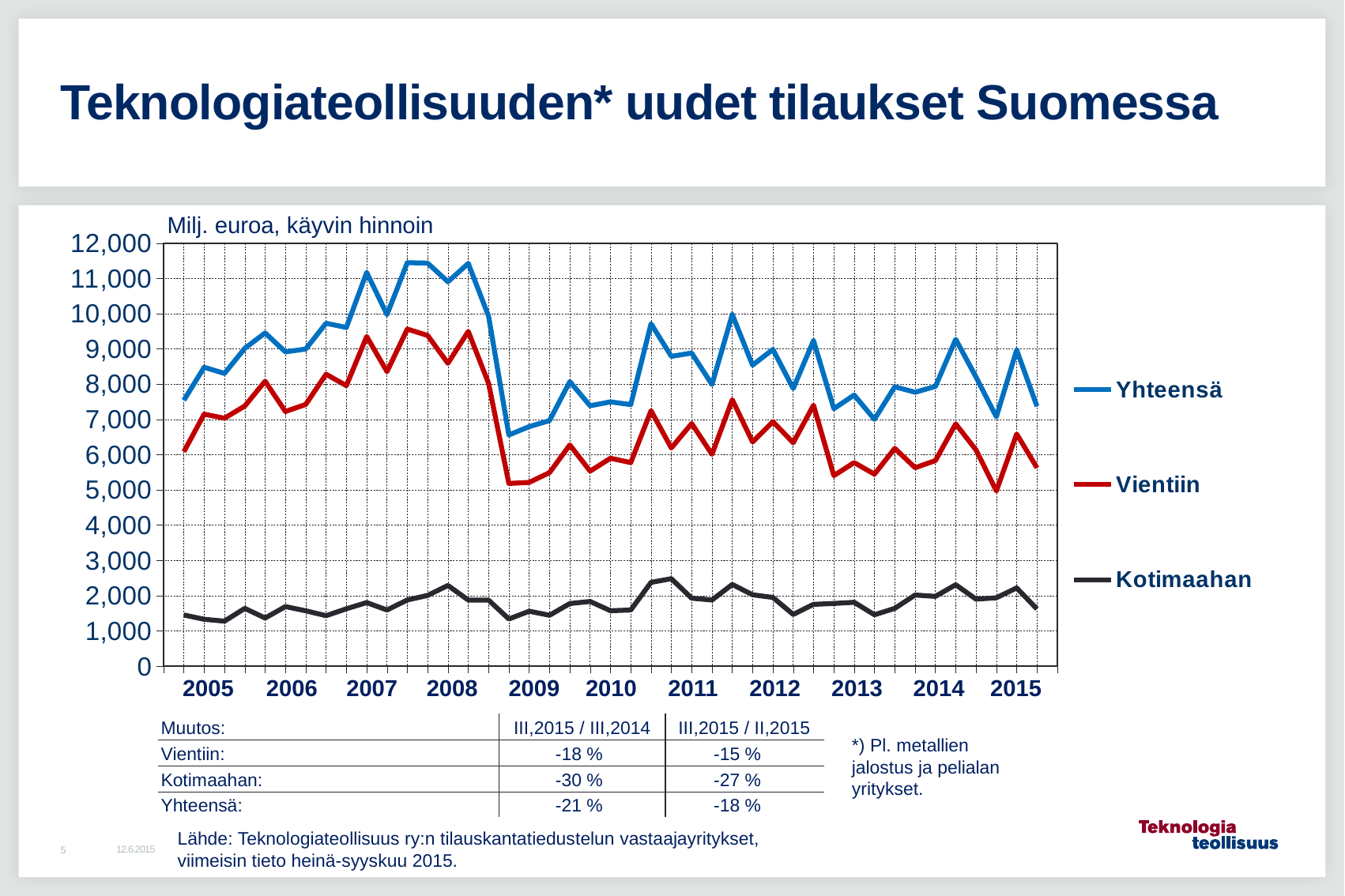
Which series has the highest values throughout the chart? Yhteensä What unit is stated above the chart? Milj. euroa, käyvin hinnoin Which is larger, the Vientiin value or the Kotimaahan value in 2012? Vientiin How many years are labelled on the x axis? 11 Is the value for Vientiin at the start of 2009 greater or less than 6,000? less Which series has the lowest values throughout the chart? Kotimaahan Is the value for Yhteensä at the start of 2009 greater or less than 8,000? less How many series does the legend list? 3 What kind of chart is shown on the slide? line chart Is the peak value for Yhteensä in 2007–2008 greater or less than 11,000? greater Does the Yhteensä series rise or fall from 2008 to 2009? fall